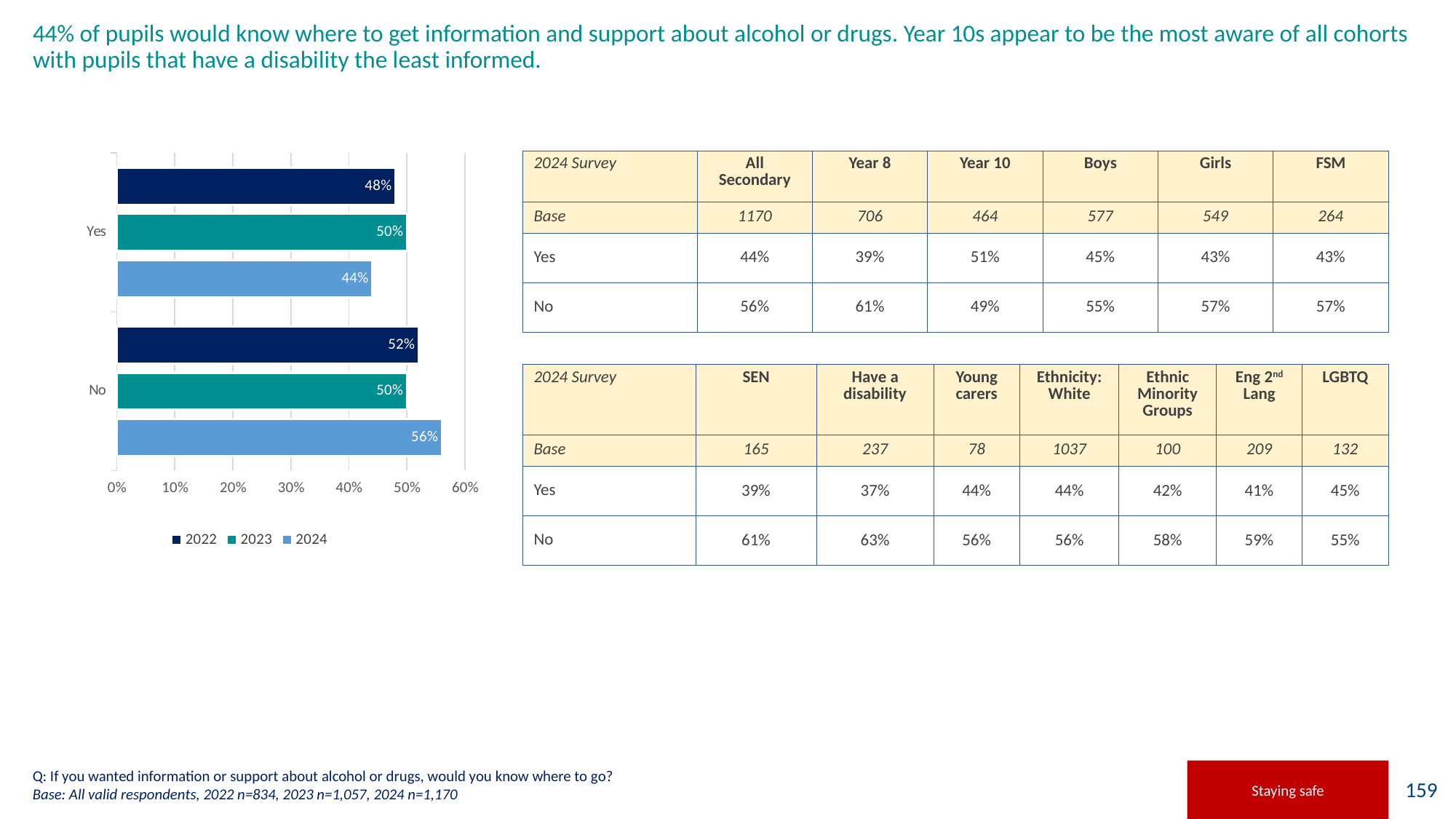
What is the difference between the Yes value in 2022 and the Yes value in 2024? 4% Does the Yes value rise or fall from 2023 to 2024? fall What is the value for Yes in 2023? 50% How many series does the legend list? 3 What is the value for No in 2024? 56% Which year has the lowest value for Yes? 2024 What is the value for Yes in 2024? 44% Which is larger: the No value in 2024 or the No value in 2023? No value in 2024 Which year has the highest value for No? 2024 What kind of chart is shown on the slide? bar chart How many categories are shown on the chart? 2 What is the value for No in 2022? 52%